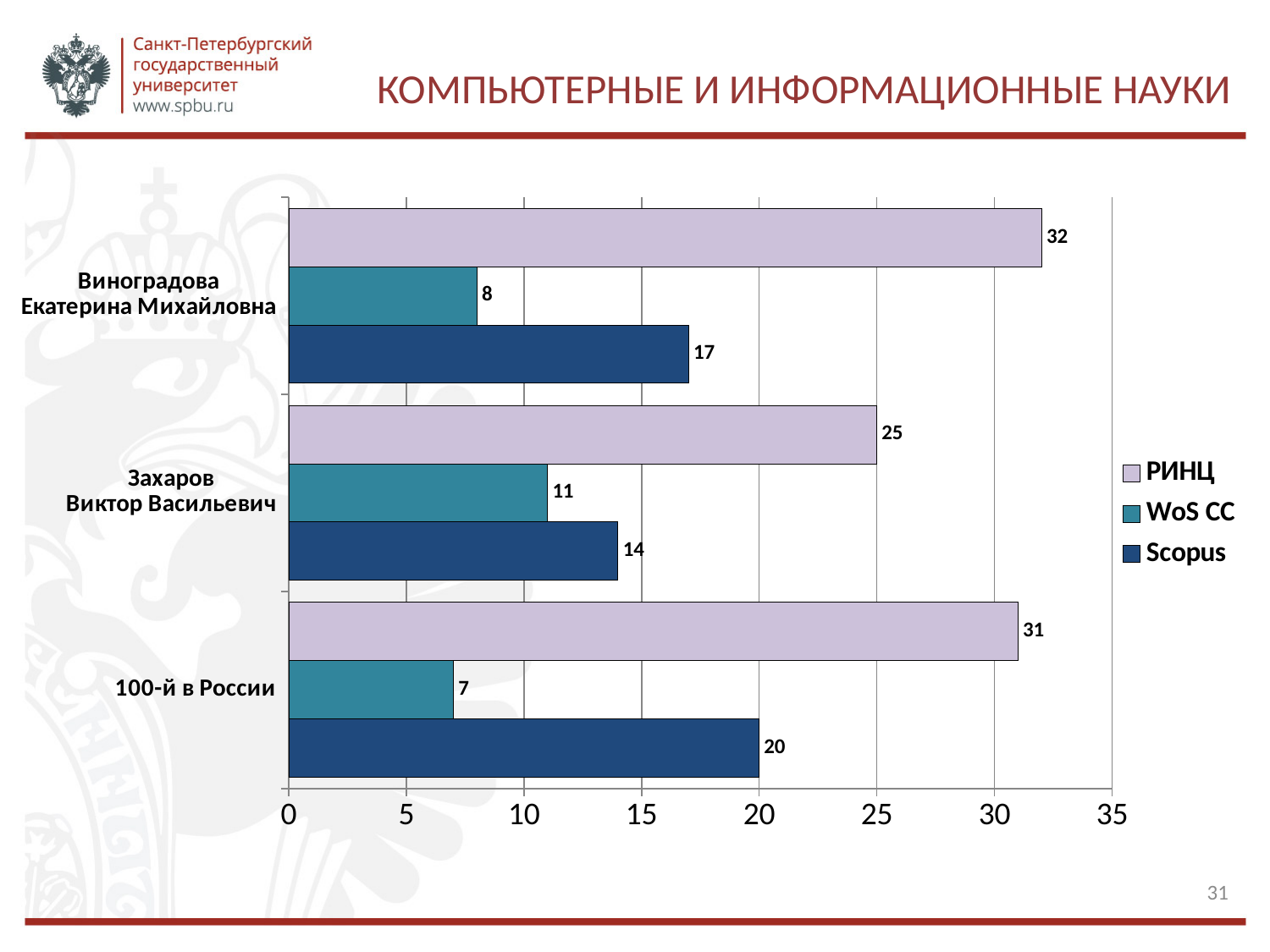
What is the title of the slide? КОМПЬЮТЕРНЫЕ И ИНФОРМАЦИОННЫЕ НАУКИ Which category has the lowest WoS CC value? 100-й в России What is the Scopus value for 100-й в России? 20 Which is larger: the Scopus value for Виноградова Екатерина Михайловна or the Scopus value for Захаров Виктор Васильевич? Виноградова Екатерина Михайловна What is the difference between the Scopus values for 100-й в России and Захаров Виктор Васильевич? 6 Is the РИНЦ value for Захаров Виктор Васильевич greater or less than 30? less What is the WoS CC value for Захаров Виктор Васильевич? 11 How many categories are shown on the y axis? 3 Which category has the highest РИНЦ value? Виноградова Екатерина Михайловна What kind of chart is shown on the slide? bar chart How many series does the legend list? 3 What is the РИНЦ value for Виноградова Екатерина Михайловна? 32